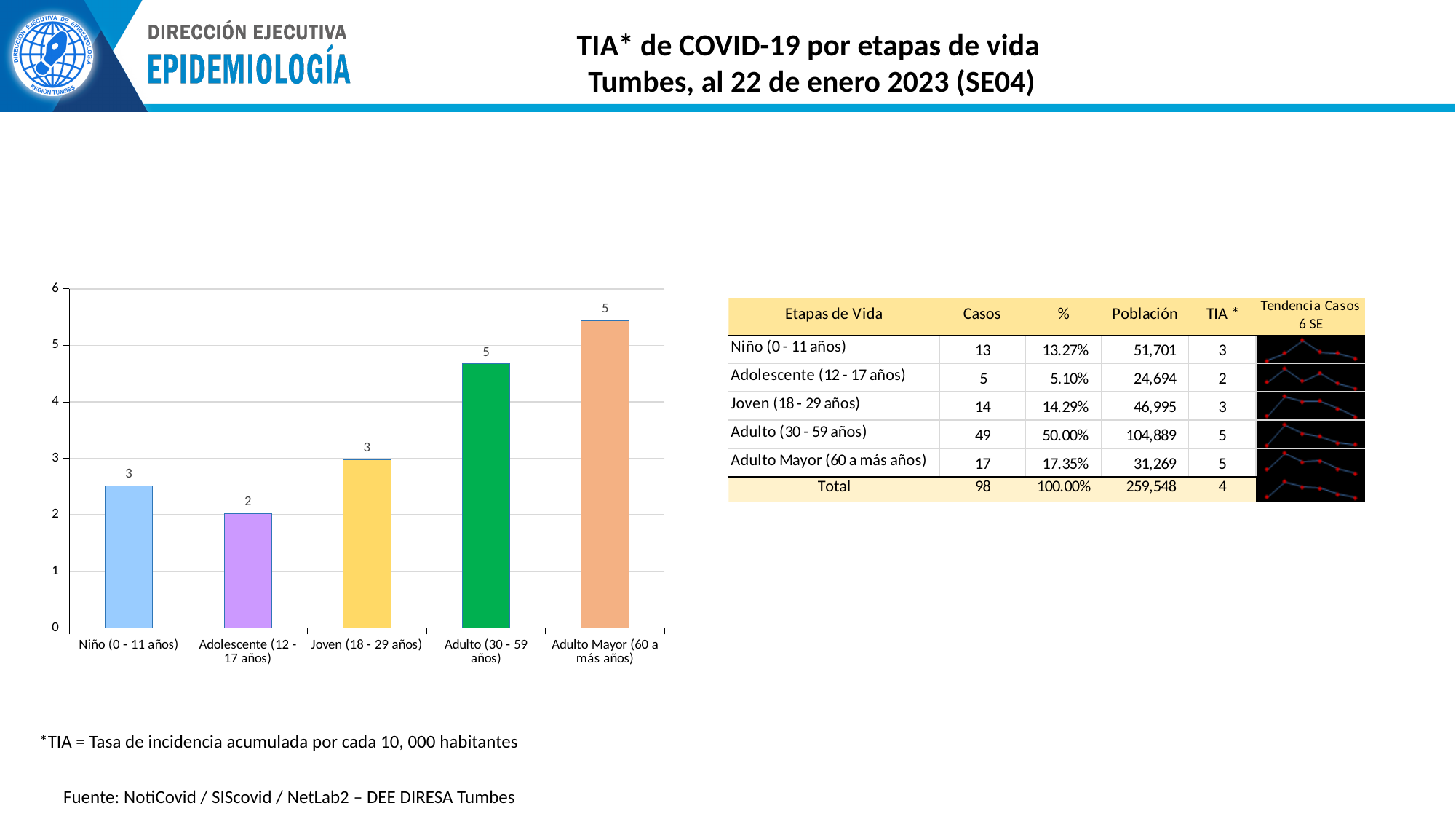
What kind of chart is shown on the slide? bar chart Which category has the lowest bar in the chart? Adolescente (12 - 17 años) What is the value shown for Adulto (30 - 59 años) in the bar chart? 5 Is the bar for Niño (0 - 11 años) greater or less than 2? greater How many categories are shown in the bar chart? 5 Which bar is taller, Adulto (30 - 59 años) or Adulto Mayor (60 a más años)? Adulto Mayor (60 a más años) What colour is the bar for Adulto (30 - 59 años)? green Which category has the highest bar in the chart? Adulto Mayor (60 a más años) What is the value shown for Adolescente (12 - 17 años) in the bar chart? 2 What is the value shown for Niño (0 - 11 años) in the bar chart? 3